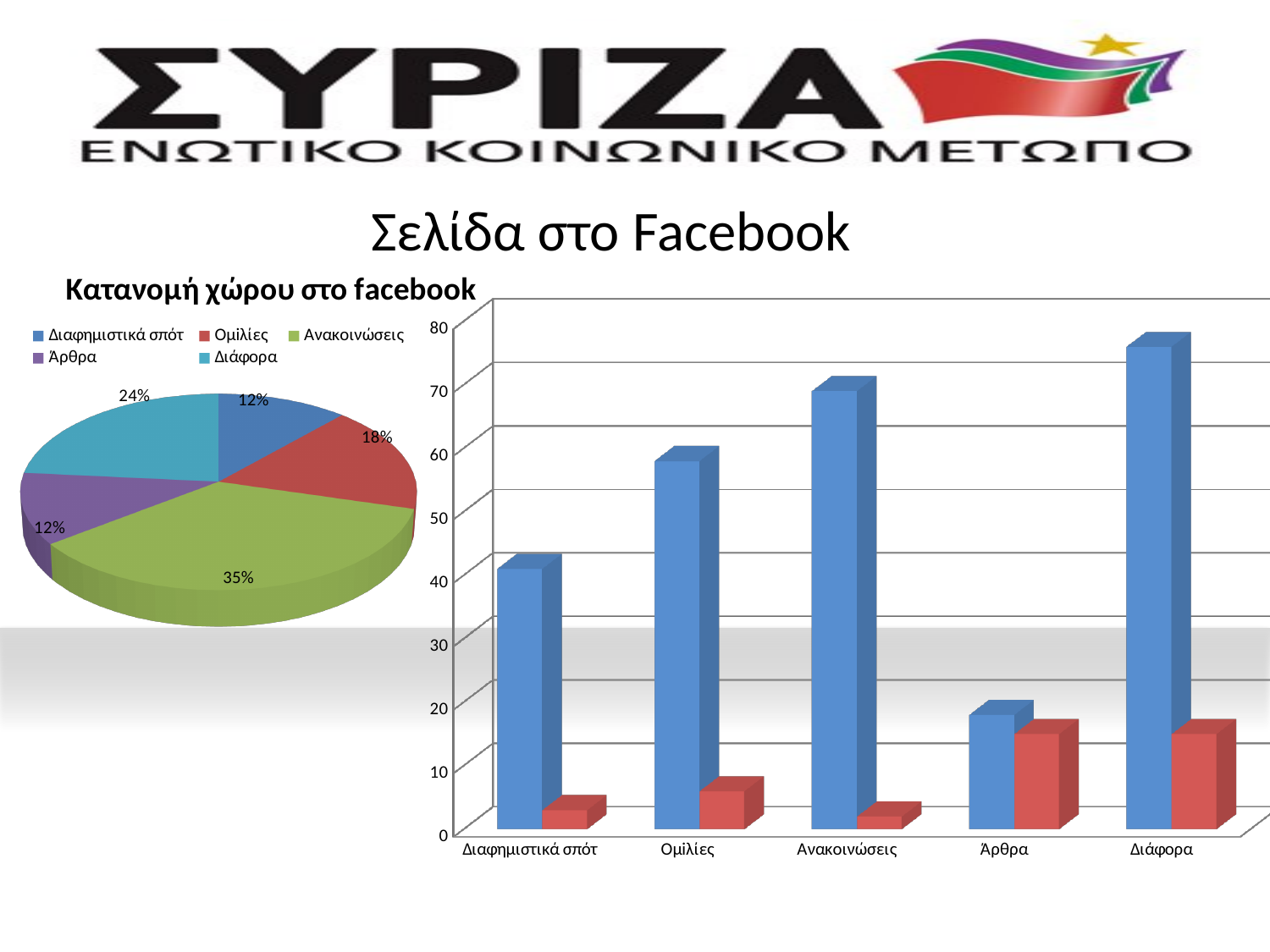
In the pie chart titled 'Κατανομή χώρου στο facebook', what share does Διάφορα have? 24% In the pie chart titled 'Κατανομή χώρου στο facebook', how many percentage points larger is the Ανακοινώσεις share than the Διάφορα share? 11% In the pie chart titled 'Κατανομή χώρου στο facebook', what share does Ομιλίες have? 18% What kind of chart is the chart on the right side of the slide? Bar chart In the bar chart on the right side of the slide, which category has the tallest blue bar? Διάφορα In the bar chart on the right side of the slide, is the blue bar for Ανακοινώσεις greater or less than 60? greater In the pie chart titled 'Κατανομή χώρου στο facebook', what share does Ανακοινώσεις have? 35% How many entries does the legend of the pie chart titled 'Κατανομή χώρου στο facebook' list? 5 In the pie chart titled 'Κατανομή χώρου στο facebook', which has the larger share, Ομιλίες or Διάφορα? Διάφορα In the bar chart on the right side of the slide, which category has the shortest blue bar? Άρθρα In the pie chart titled 'Κατανομή χώρου στο facebook', which category has the largest share? Ανακοινώσεις